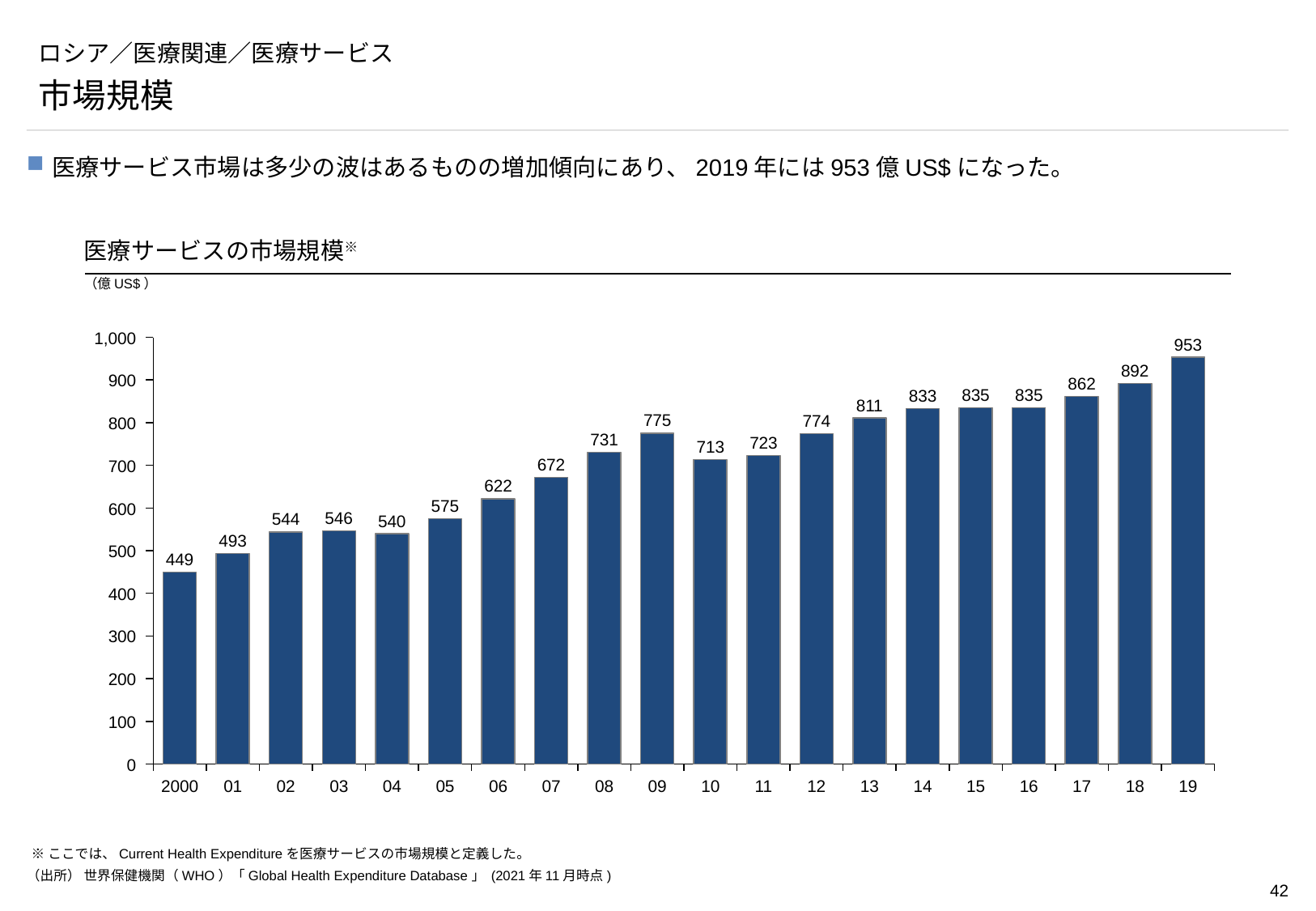
What is the value for 09? 775 How many years are shown on the x axis? 20 Which year has the lowest value? 2000 Do the values generally rise or fall from 2000 to 19? rise What is the difference between the values for 19 and 18? 61 What unit is shown for the chart's values? 億 US$ Which is larger, the value for 09 or the value for 10? 09 What is the value for 2019? 953 Is the value for 06 greater or less than 600? greater What kind of chart is this? bar chart What is the value for 2000? 449 Which year has the highest value? 19